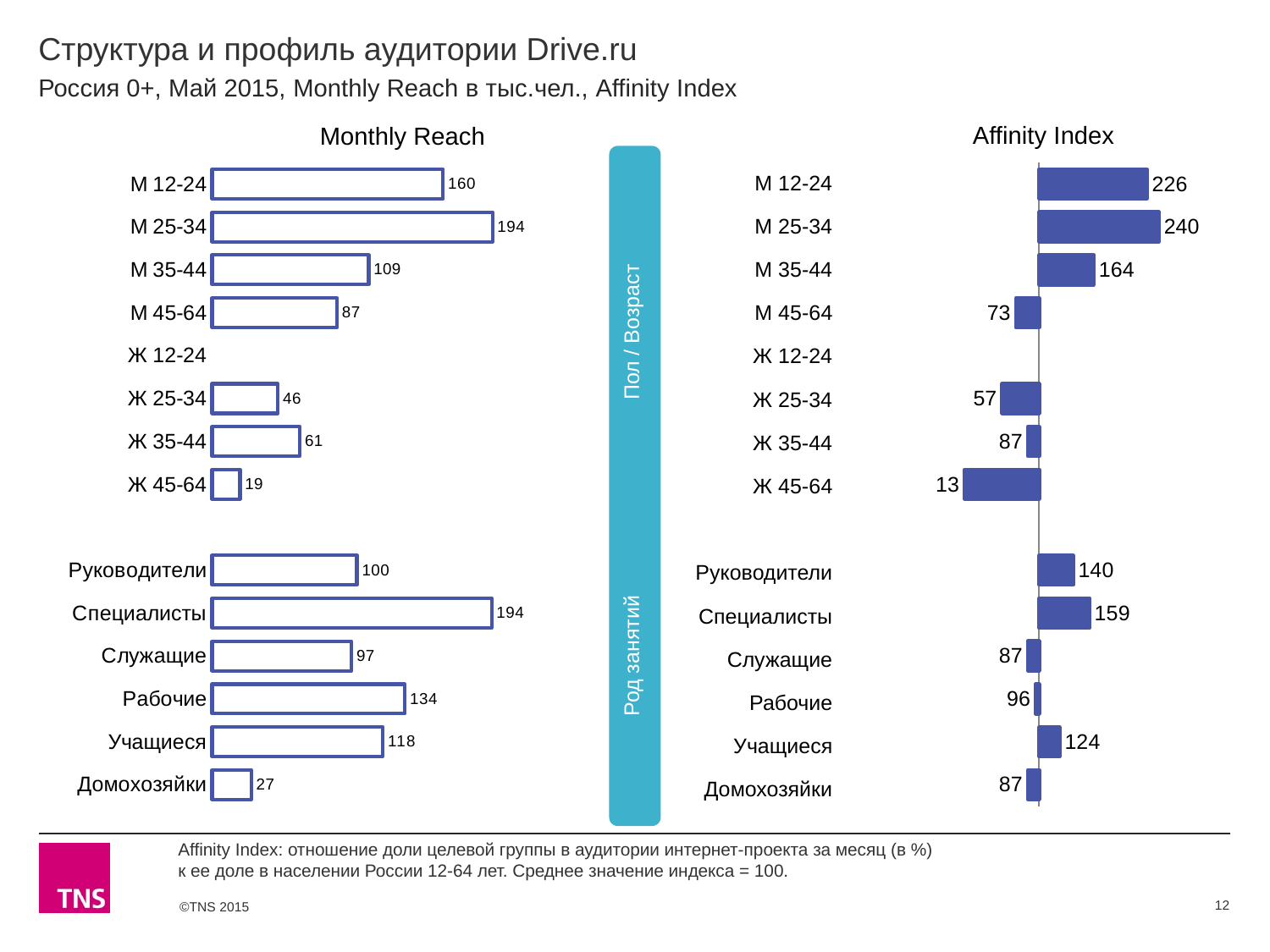
In the Monthly Reach chart, what is the value for Домохозяйки? 27 What type of chart is the Affinity Index chart? bar chart In the Affinity Index chart, what is the value for Учащиеся? 124 In the Monthly Reach chart, how many categories are in the Род занятий group? 6 In the Monthly Reach chart, which is larger: Руководители or Служащие? Руководители In the Monthly Reach chart, what is the value for М 25-34? 194 In the Monthly Reach chart, which category in the Пол / Возраст group has the lowest value? Ж 45-64 In the Monthly Reach chart, what is the difference between Рабочие and Учащиеся? 16 In the Affinity Index chart, what is the value for Ж 45-64? 13 In the Affinity Index chart, which category has the highest value? М 25-34 In the Affinity Index chart, which is larger: Ж 25-34 or М 45-64? М 45-64 In the Affinity Index chart, what is the difference between М 12-24 and М 35-44? 62